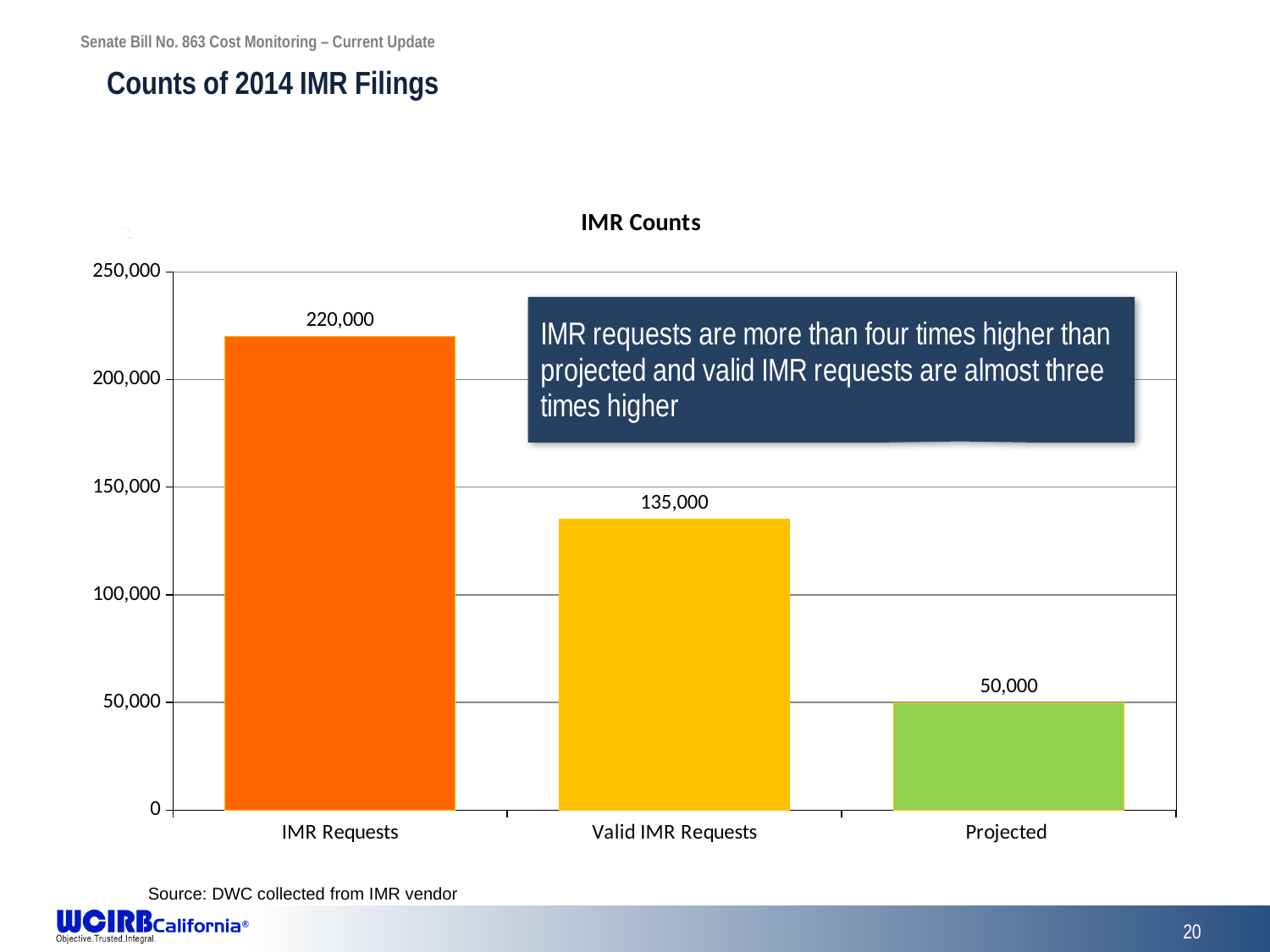
What is the title of the chart? IMR Counts How many categories are shown on the chart? 3 What is the difference between IMR Requests and Valid IMR Requests? 85,000 What is the difference between IMR Requests and Projected? 170,000 Which is larger, Valid IMR Requests or Projected? Valid IMR Requests What kind of chart is shown? bar chart Which category has the highest value? IMR Requests What is the value for IMR Requests? 220,000 Is the value for Valid IMR Requests greater or less than 150,000? less What is the value for Projected? 50,000 What is the value for Valid IMR Requests? 135,000 Which category has the lowest value? Projected